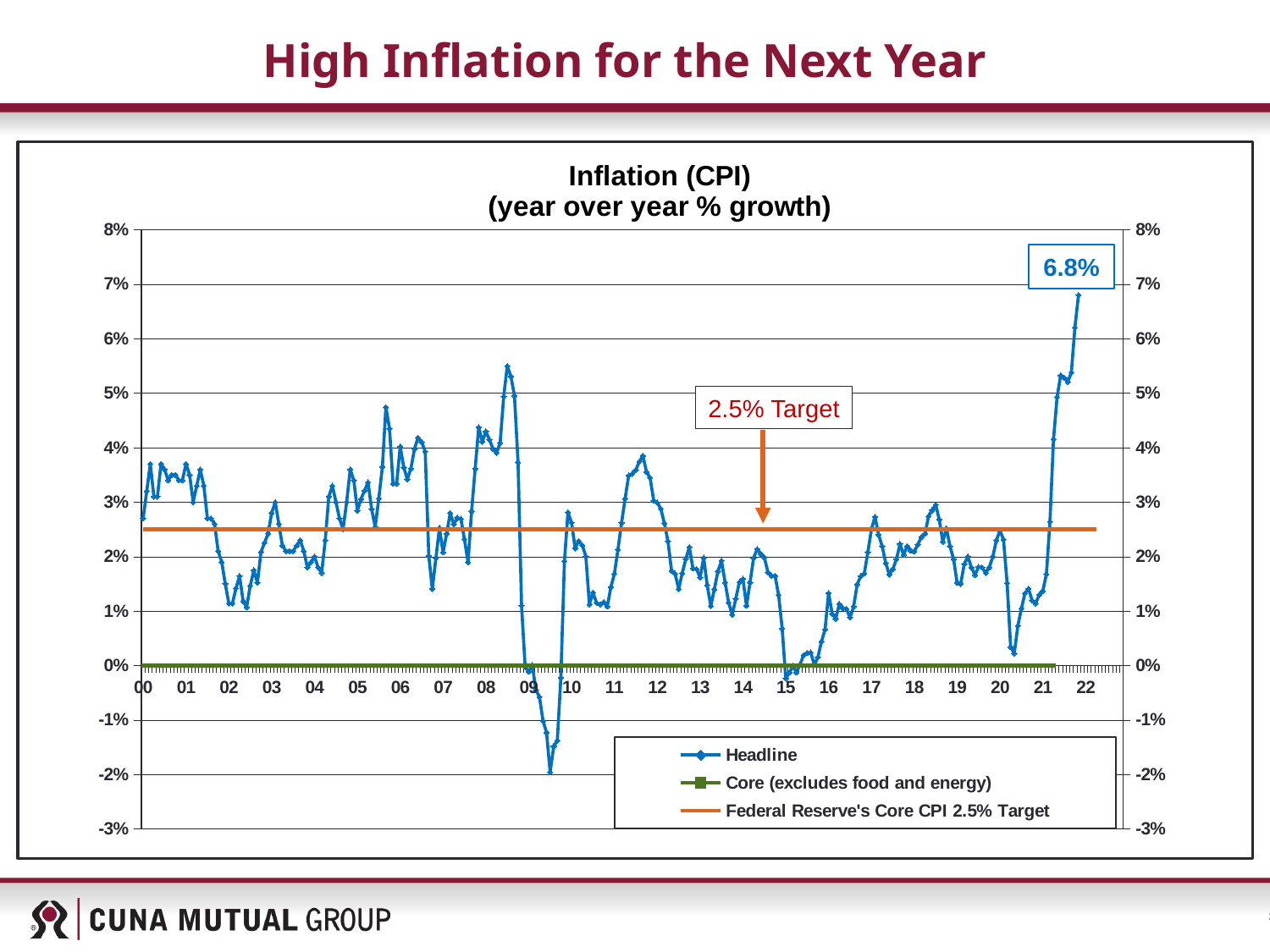
What is the title of the chart? Inflation (CPI) (year over year % growth) What kind of chart is shown on the slide? Line chart Does the Headline series rise or fall from 2020 to the end of the chart? Rise By how many percentage points does the latest Headline value of 6.8% exceed the 2.5% target? 4.3 percentage points Is the lowest Headline value, reached around 2009, greater or less than -1%? less Is the Headline value in early 2015 greater or less than 1%? less Is the Headline peak in 2008 greater or less than 5%? greater What is the highest value reached by the Headline series on the chart? 6.8% What is the latest Headline inflation value labelled on the chart? 6.8% How many series does the legend list? 3 What is the Federal Reserve's Core CPI target shown on the chart? 2.5% Which is larger, the latest Headline value or the Federal Reserve's 2.5% target? Headline